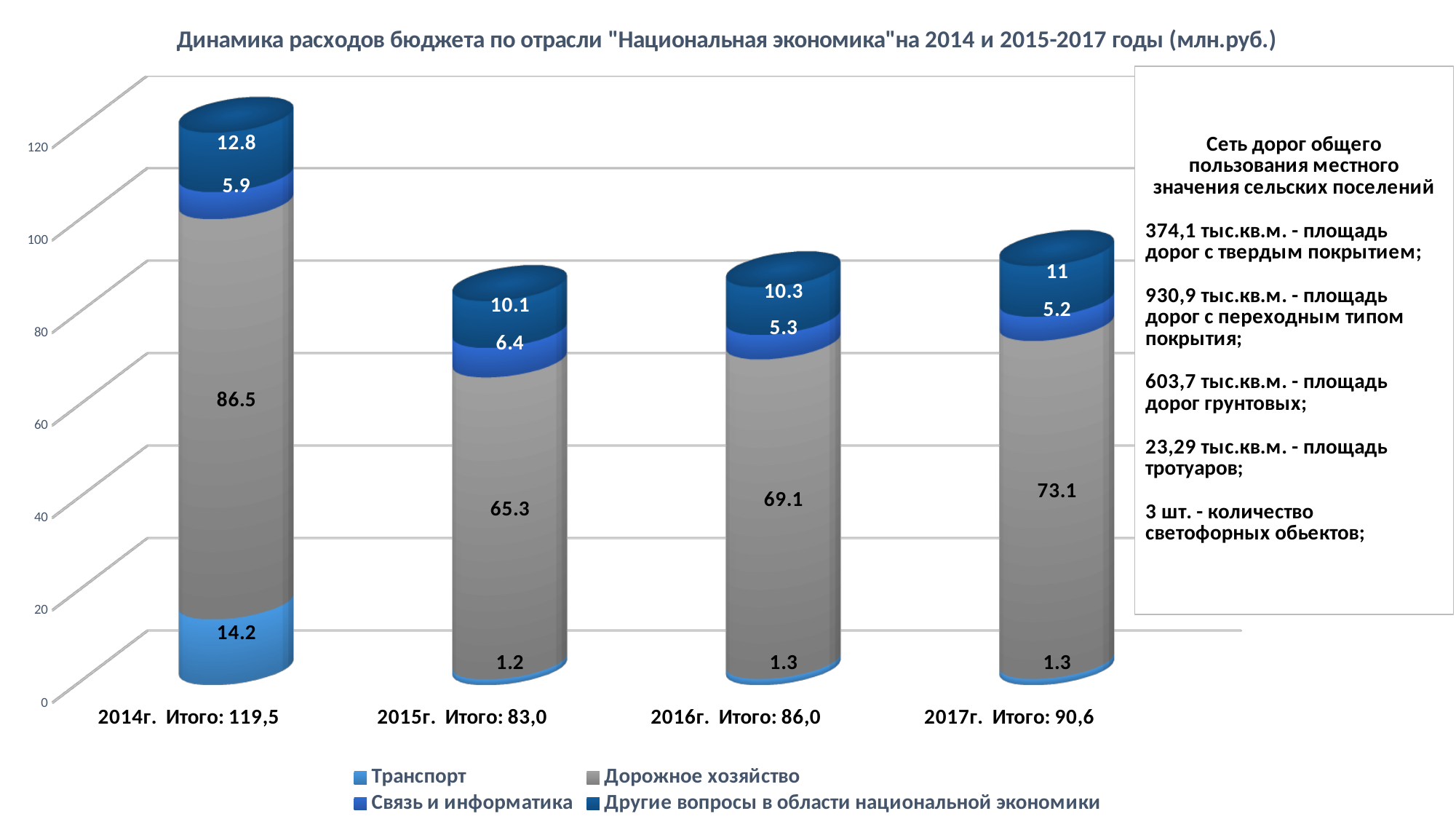
Which year has the larger value for Связь и информатика, 2015 or 2016? 2015г. In which year is the value for Дорожное хозяйство the highest? 2014г. What is the value for Связь и информатика in 2015? 6.4 What is the difference between the values for Другие вопросы в области национальной экономики in 2014 and 2015? 2.7 How many series does the legend list? 4 What kind of chart is shown on the slide? Stacked bar chart What is the total of the stacked bar for 2015г.? 83,0 What is the value for Дорожное хозяйство in 2014? 86.5 What is the value for Другие вопросы в области национальной экономики in 2017? 11 In which year is the value for Транспорт the lowest? 2015г. How many years (categories) are shown on the x axis? 4 What is the value for Транспорт in 2014? 14.2